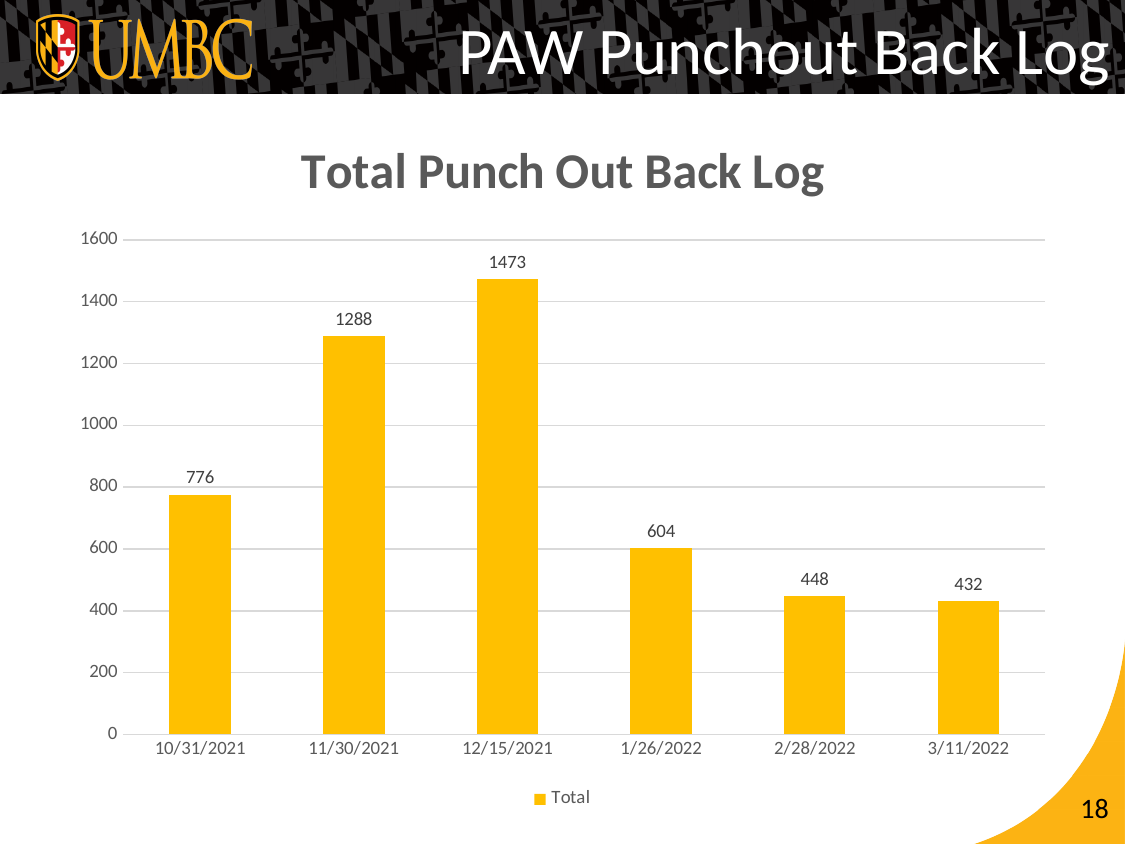
What is the difference between the back log on 11/30/2021 and on 10/31/2021? 512 How many dates are shown on the x axis of the chart? 6 What is the total punch out back log on 12/15/2021? 1473 What is the title of the chart? Total Punch Out Back Log Is the value for 1/26/2022 greater or less than 800? less Which is larger, the back log on 11/30/2021 or on 1/26/2022? 11/30/2021 What is the difference between the back log on 12/15/2021 and on 1/26/2022? 869 Which date has the highest total punch out back log? 12/15/2021 What is the total punch out back log on 2/28/2022? 448 What kind of chart is shown on the slide? bar chart Which date has the lowest total punch out back log? 3/11/2022 What is the total punch out back log on 10/31/2021? 776